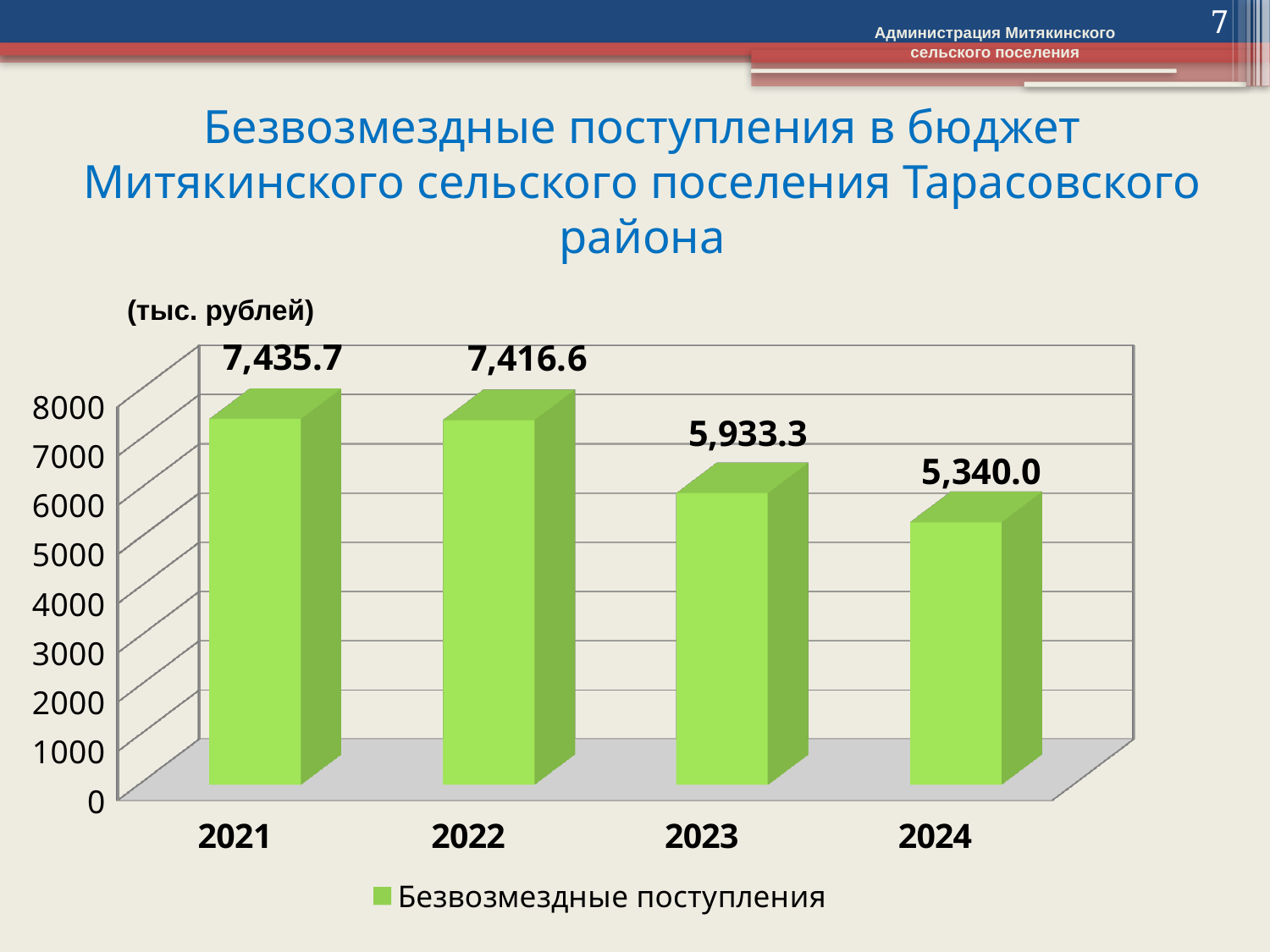
What is the difference between the values for 2022 and 2023? 1,483.3 Do the values rise or fall from 2021 to 2024? fall How many years are shown on the x axis? 4 Which year has the highest value? 2021 What is the value for 2021? 7,435.7 What kind of chart is shown? bar chart What is the value for 2024? 5,340.0 Which year has the lowest value? 2024 Which is larger, the value for 2022 or the value for 2024? 2022 What is the value for 2023? 5,933.3 How many series does the legend list? 1 What is the difference between the values for 2023 and 2024? 593.3